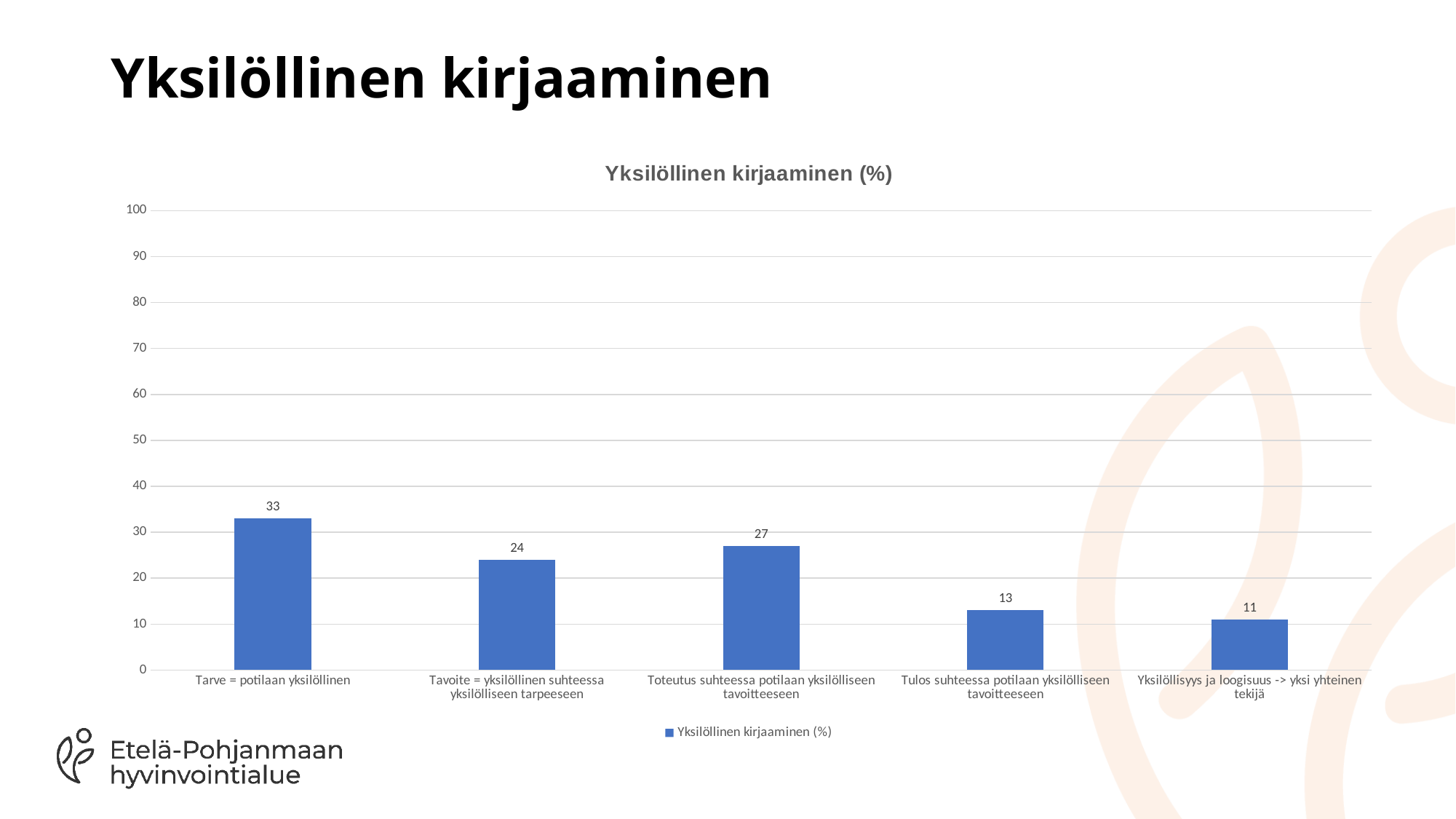
Which category has the lowest value? Yksilöllisyys ja loogisuus -> yksi yhteinen tekijä Which is larger, the value for "Tavoite = yksilöllinen suhteessa yksilölliseen tarpeeseen" or "Toteutus suhteessa potilaan yksilölliseen tavoitteeseen"? Toteutus suhteessa potilaan yksilölliseen tavoitteeseen What is the title of the chart? Yksilöllinen kirjaaminen (%) What kind of chart is shown on the slide? bar chart What is the value for "Yksilöllisyys ja loogisuus -> yksi yhteinen tekijä"? 11 What is the value for "Tarve = potilaan yksilöllinen"? 33 What is the value for "Tavoite = yksilöllinen suhteessa yksilölliseen tarpeeseen"? 24 Is the value for "Tulos suhteessa potilaan yksilölliseen tavoitteeseen" greater or less than 20? less What is the value for "Toteutus suhteessa potilaan yksilölliseen tavoitteeseen"? 27 How many categories are shown on the chart? 5 Which category has the highest value? Tarve = potilaan yksilöllinen What is the difference between the values for "Tarve = potilaan yksilöllinen" and "Tulos suhteessa potilaan yksilölliseen tavoitteeseen"? 20